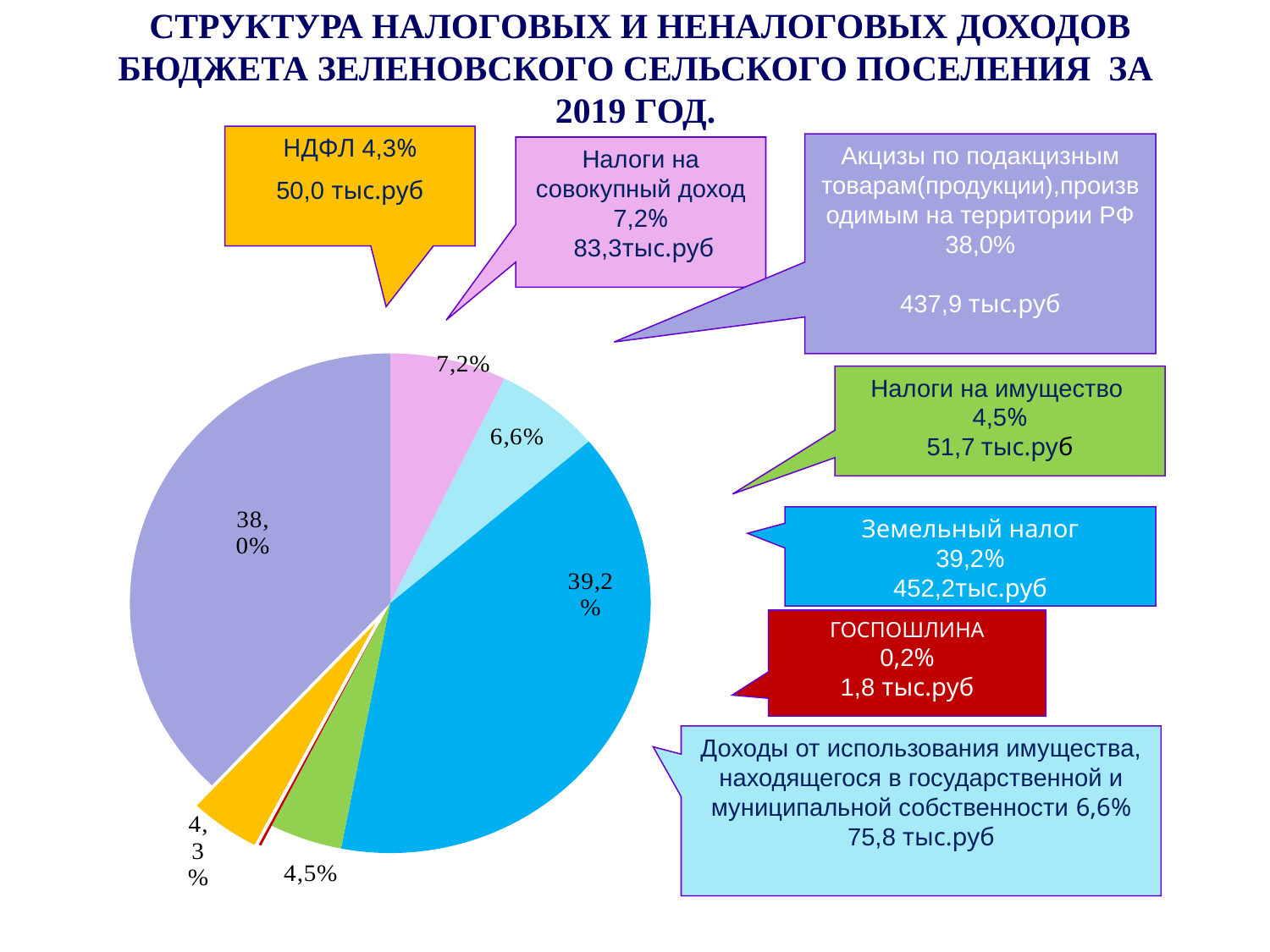
What is the value in тыс.руб for Налоги на имущество? 51,7 тыс.руб Which category has the smallest slice of the pie? ГОСПОШЛИНА Which is larger: the share for Налоги на совокупный доход or the share for Доходы от использования имущества? Налоги на совокупный доход Which category has the largest slice of the pie? Земельный налог What is the difference in percentage points between the Земельный налог share and the Акцизы share? 1,2 What is the value in тыс.руб for НДФЛ? 50,0 тыс.руб What colour is the slice for Земельный налог? blue What share of the pie does Земельный налог account for? 39,2% What kind of chart is shown on the slide? pie chart What share of the pie does Акцизы по подакцизным товарам account for? 38,0% How many slices does the pie chart have? 7 What is the value in тыс.руб for ГОСПОШЛИНА? 1,8 тыс.руб